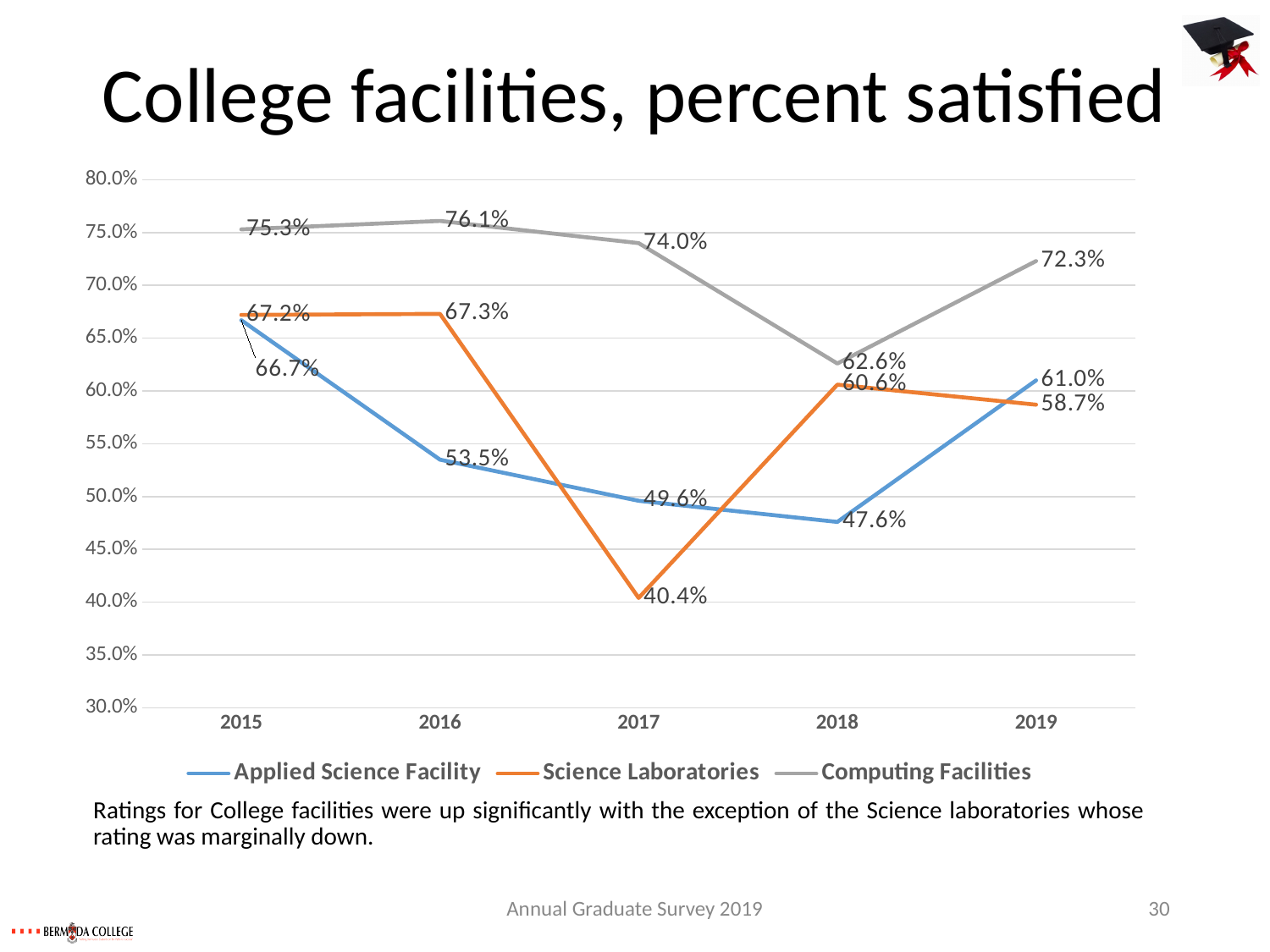
What kind of chart is shown on the slide? Line chart In which year was satisfaction with Science Laboratories lowest? 2017 Did satisfaction with the Applied Science Facility rise or fall from 2015 to 2018? Fall How many years are shown on the x axis? 5 How many series does the legend list? 3 What was the percent satisfied with Computing Facilities in 2016? 76.1% What was the percent satisfied with Science Laboratories in 2017? 40.4% What colour is the Science Laboratories line? Orange By how many percentage points did satisfaction with Computing Facilities rise from 2018 to 2019? 9.7 percentage points In 2019, which had the higher percent satisfied: the Applied Science Facility or Science Laboratories? Applied Science Facility In which year was satisfaction with Computing Facilities highest? 2016 What was the percent satisfied with the Applied Science Facility in 2018? 47.6%